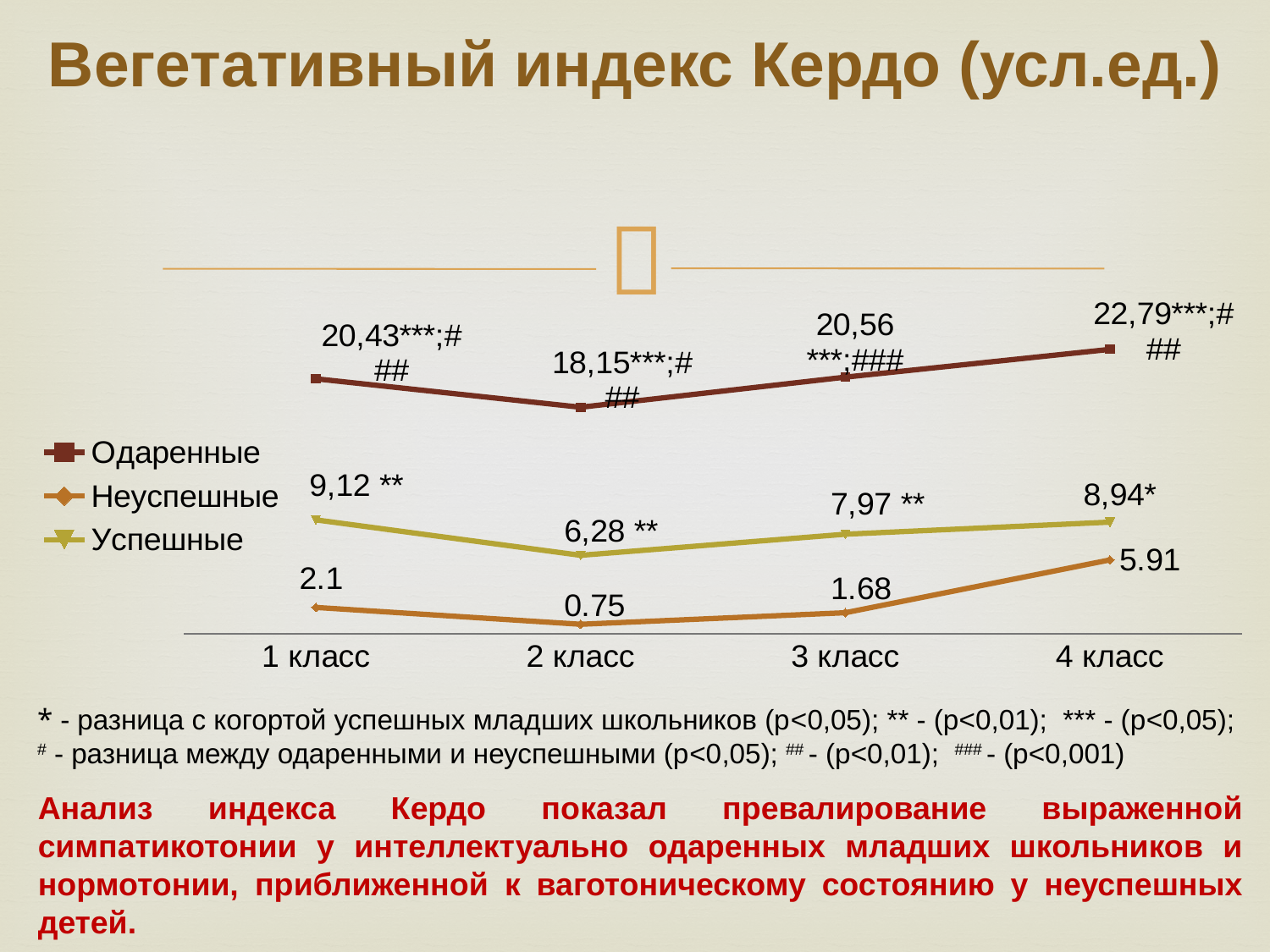
How many categories are shown on the x axis? 4 How many series does the legend list? 3 What is the value for Неуспешные in 2 класс? 0.75 What kind of chart is shown on the slide? line chart Which is larger in 3 класс: the value for Успешные or the value for Неуспешные? Успешные What are the three series listed in the legend? Одаренные, Неуспешные, Успешные In which class is the value for Неуспешные the lowest? 2 класс What is the value for Одаренные in 1 класс? 20,43 Does the value for Неуспешные rise or fall from 2 класс to 4 класс? rise What is the value for Успешные in 4 класс? 8,94 What is the difference between the Успешные values in 1 класс and 2 класс? 2,84 In which class is the value for Одаренные the highest? 4 класс